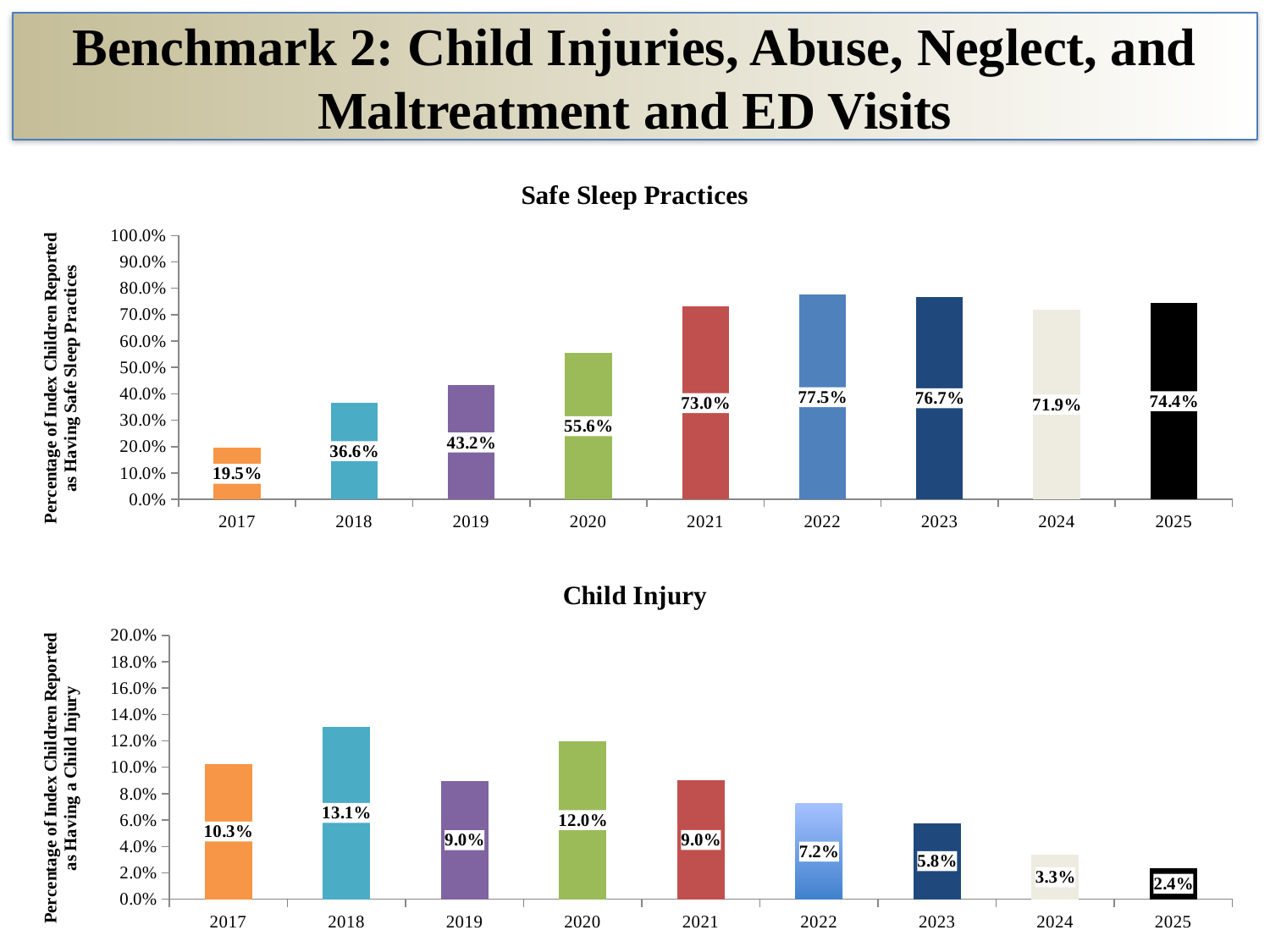
In the Safe Sleep Practices chart, which year has the highest value? 2022 In the Child Injury chart, is the value for 2022 greater or less than 6.0%? greater In the Safe Sleep Practices chart, which year has the lowest value? 2017 In the Child Injury chart, what is the value for 2024? 3.3% In the Safe Sleep Practices chart, what is the value for 2020? 55.6% In the Safe Sleep Practices chart, which is larger, the value for 2021 or the value for 2024? 2021 In the Child Injury chart, which year has the lowest value? 2025 How many years are shown on the x axis of the Child Injury chart? 9 What type of chart is the Safe Sleep Practices chart? Bar chart In the Safe Sleep Practices chart, what is the difference between the values for 2025 and 2017? 54.9% In the Child Injury chart, what is the difference between the values for 2018 and 2023? 7.3% In the Child Injury chart, which year has the highest value? 2018